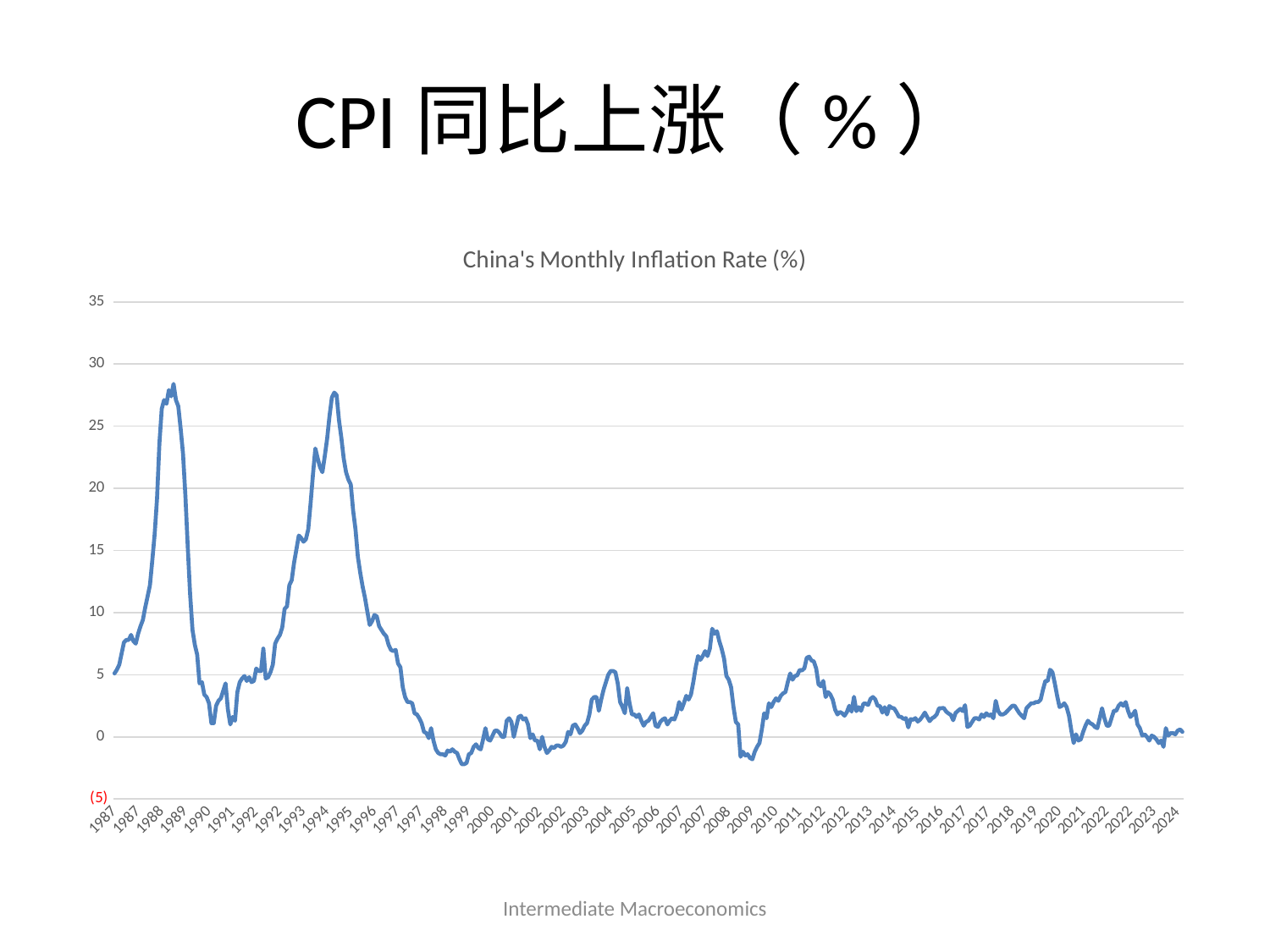
Is the peak value of the inflation rate around 2008 greater or less than 10? less Which is larger, the peak inflation rate around 1989 or the peak around 2008? the peak around 1989 What kind of chart is shown on the slide? line chart Is the inflation rate around 1999 greater or less than 0? less What is the highest value shown on the vertical axis of the chart? 35 Is the peak value of the inflation rate around 1989 greater or less than 25? greater What is the title printed above the chart's plot area? China's Monthly Inflation Rate (%) Do the inflation rate values generally rise or fall from the 1994 peak to 1999? fall